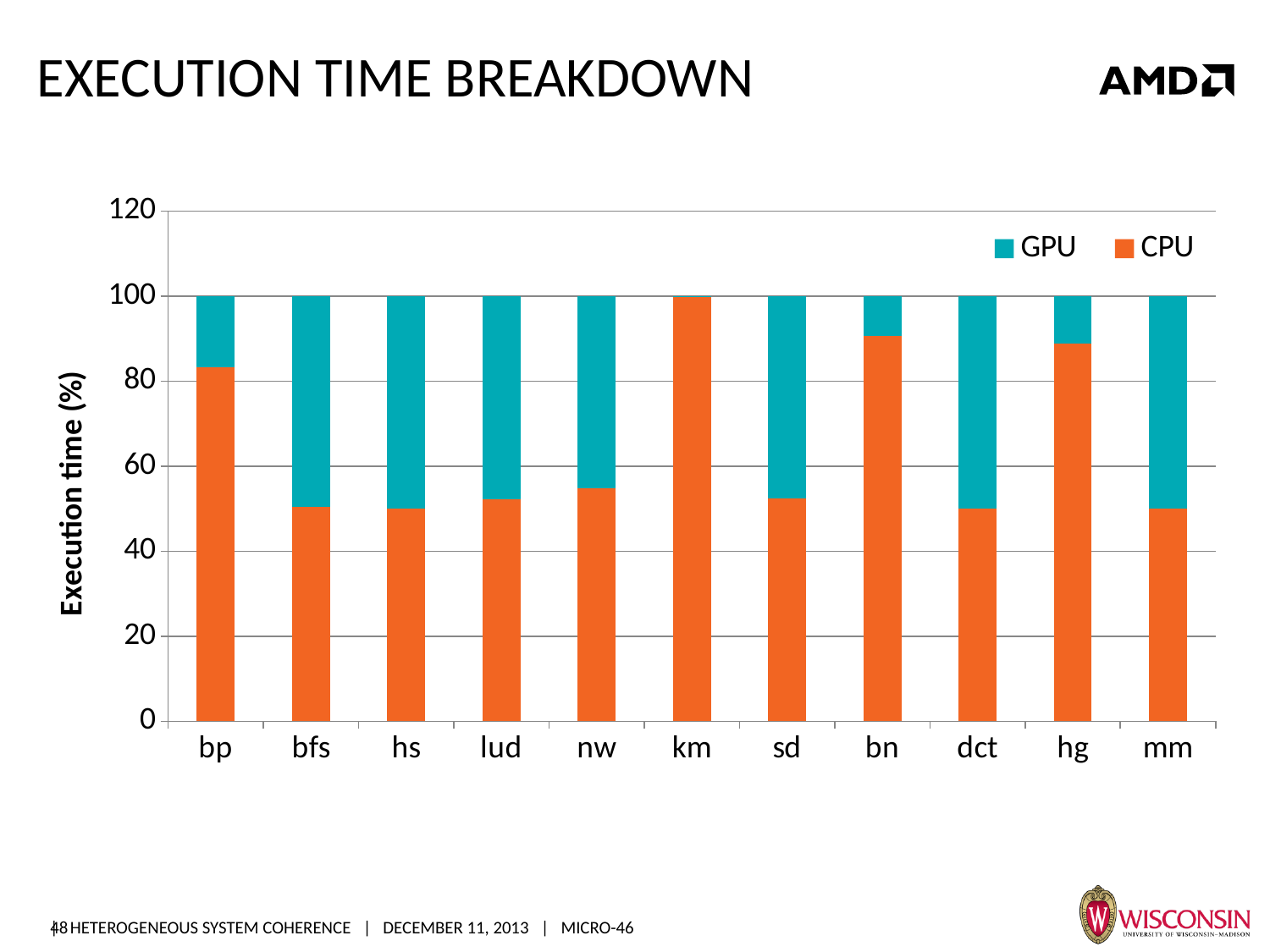
Which is larger, the GPU value for dct or the GPU value for hg? dct What is the total height of the stacked bar for lud? 100 Which is larger, the CPU value for bn or the CPU value for nw? bn What kind of chart is shown on the slide? stacked bar chart Is the CPU value for bfs greater or less than 60? less What is the label on the y axis? Execution time (%) How many benchmark categories are shown on the x axis? 11 How many series does the legend list? 2 Which benchmark has the smallest GPU share of execution time? km Is the CPU value for km greater or less than 80? greater Which benchmark has the largest CPU share of execution time? km Is the CPU value for bp greater or less than 60? greater